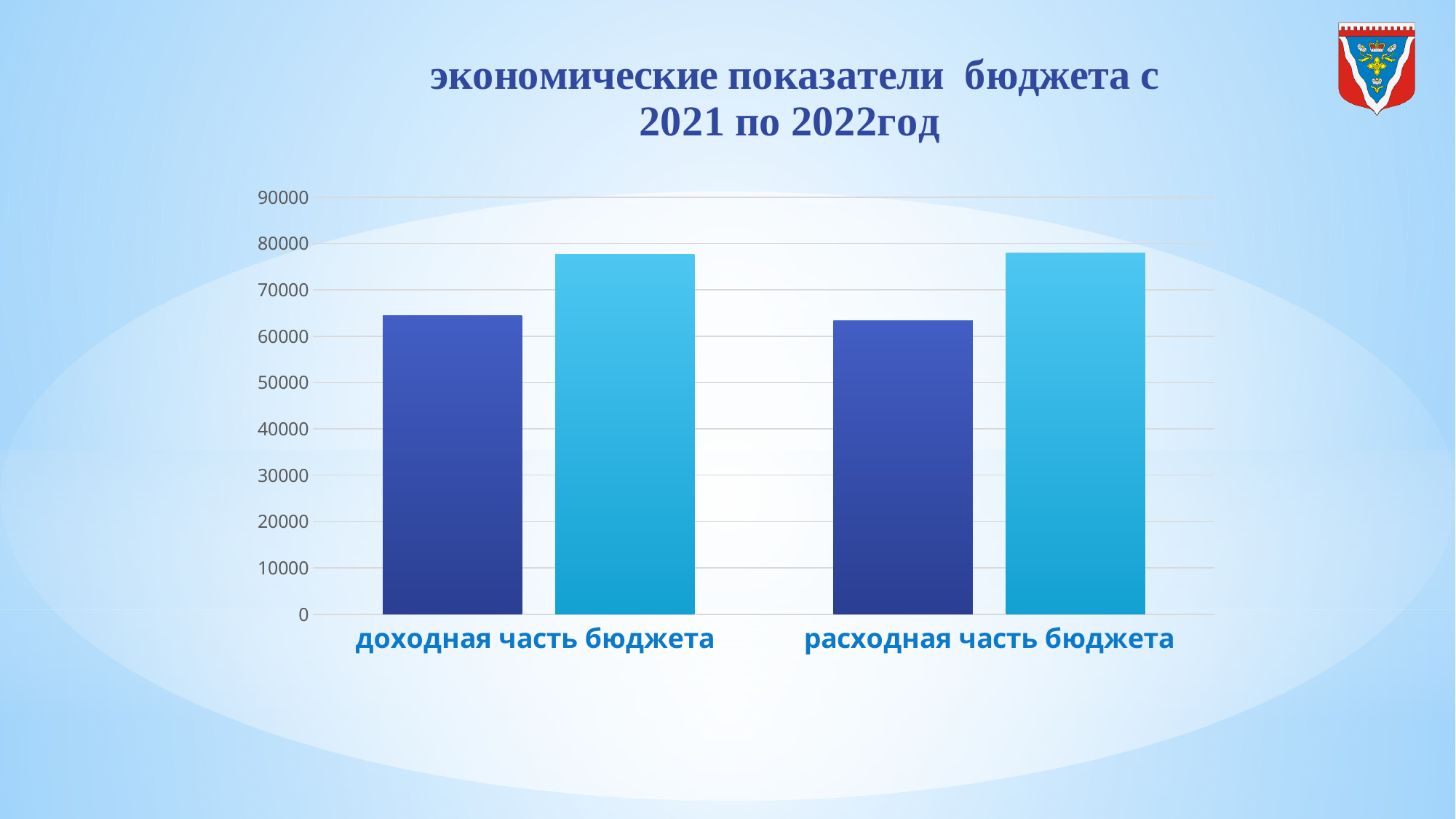
How many categories are shown on the x axis of the chart? 2 Is the value of the light blue bar for 'доходная часть бюджета' greater or less than 70000? greater What is the highest value shown on the vertical axis of the chart? 90000 Is the value of the dark blue bar for 'расходная часть бюджета' greater or less than 70000? less What kind of chart is shown on the slide? bar chart For 'доходная часть бюджета', which bar is taller, the dark blue one or the light blue one? the light blue one What is the title of the slide containing the chart? экономические показатели бюджета с 2021 по 2022год Is the value of the dark blue bar for 'доходная часть бюджета' greater or less than 60000? greater How many bars are plotted for the category 'доходная часть бюджета'? 2 For 'расходная часть бюджета', which bar is shorter, the dark blue one or the light blue one? the dark blue one